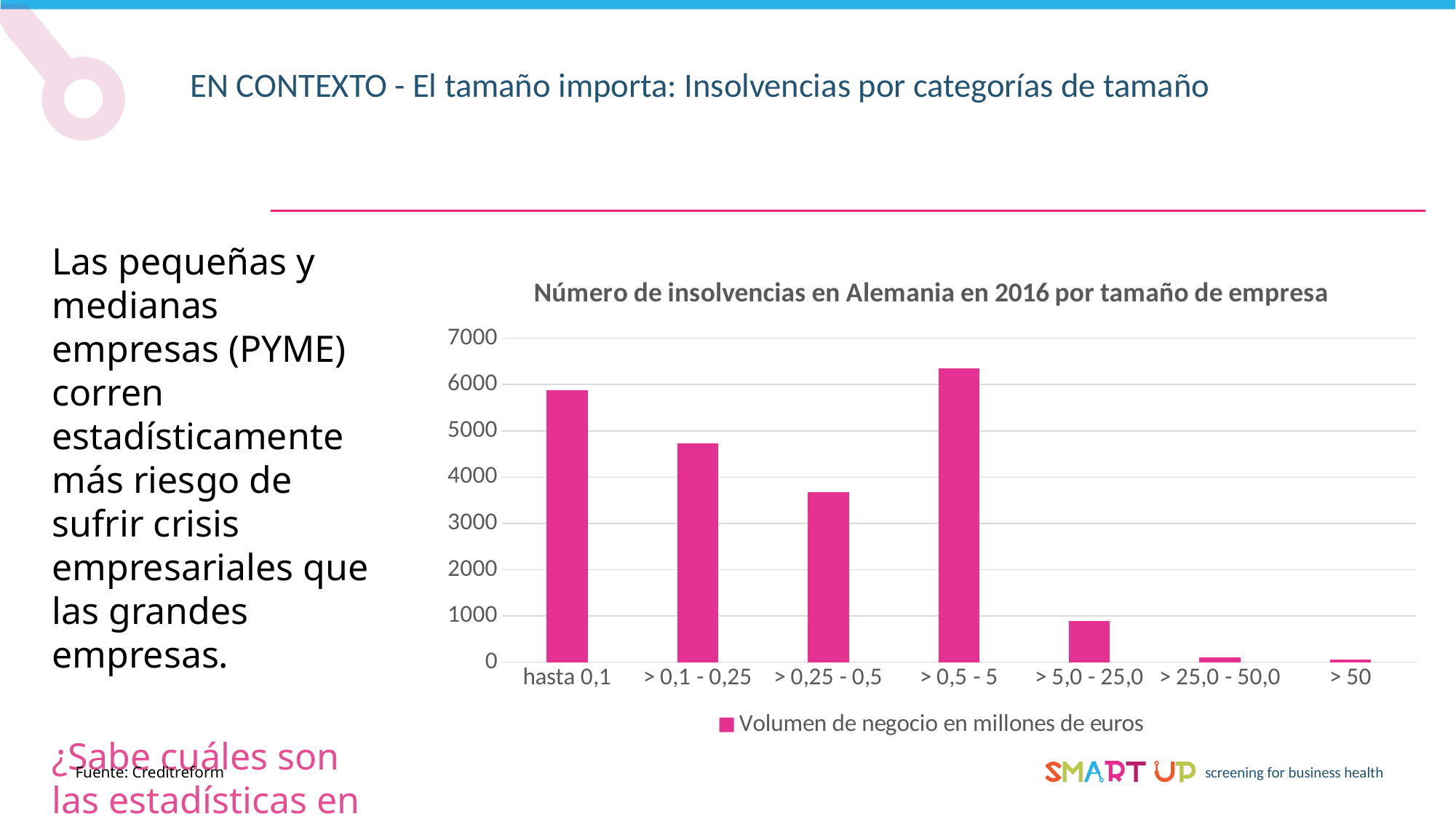
How many size categories are shown on the x axis of the chart? 7 Which has a higher value, 'hasta 0,1' or '> 0,1 - 0,25'? hasta 0,1 Which size category has the lowest number of insolvencies? > 50 What is the title of the chart? Número de insolvencias en Alemania en 2016 por tamaño de empresa Is the value for 'hasta 0,1' greater or less than 5000? greater What type of chart is shown on the slide? Bar chart Which size category has the highest number of insolvencies? > 0,5 - 5 How many series does the chart legend list? 1 What is the legend entry of the chart? Volumen de negocio en millones de euros Is the value for '> 0,1 - 0,25' greater or less than 5000? less Is the value for '> 0,5 - 5' greater or less than 6000? greater